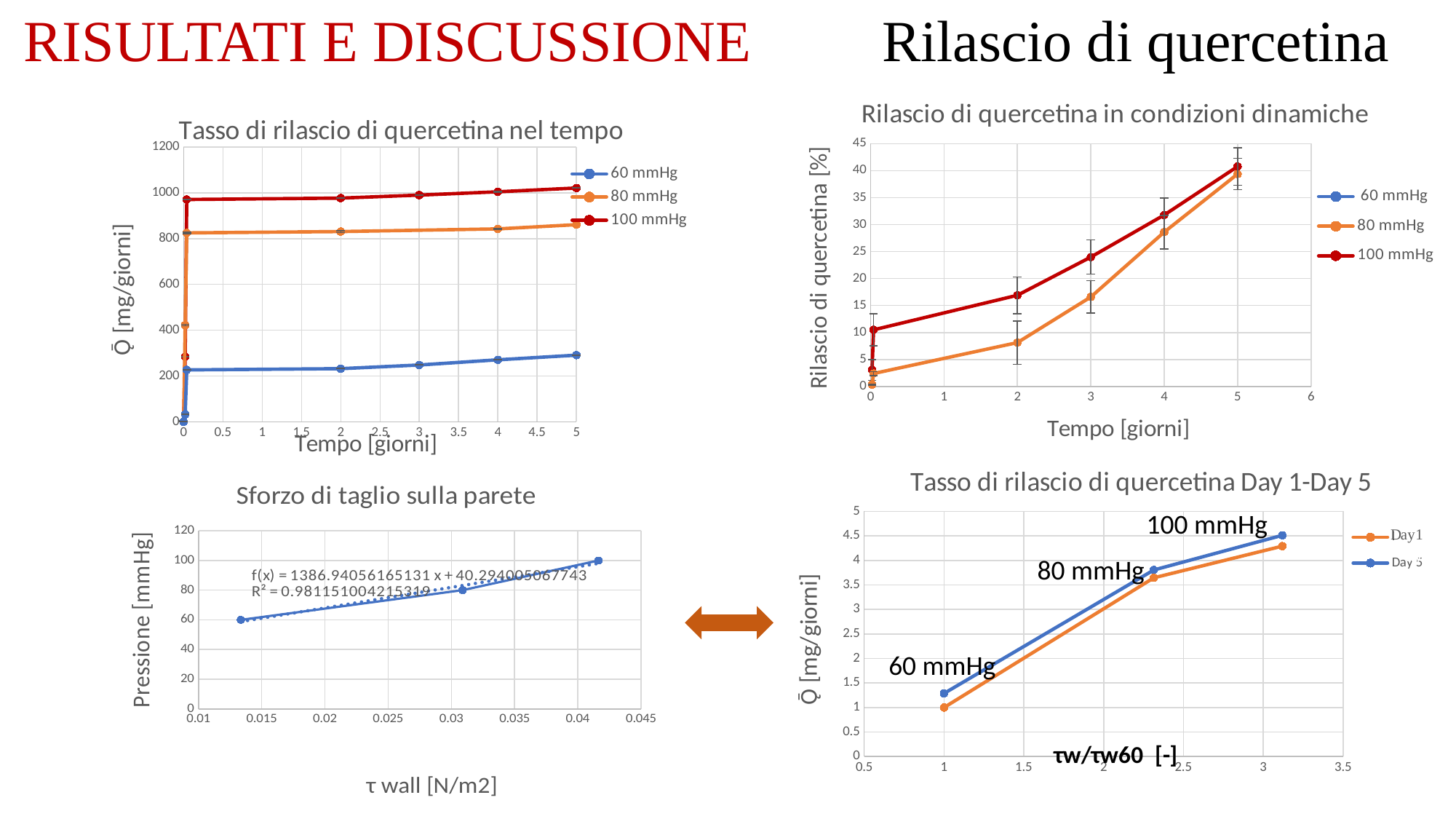
In the top-left chart 'Tasso di rilascio di quercetina nel tempo', is the value for 100 mmHg at day 5 greater or less than 800? greater In the top-left chart 'Tasso di rilascio di quercetina nel tempo', which series has the higher value at day 3: 100 mmHg or 60 mmHg? 100 mmHg In the top-right chart 'Rilascio di quercetina in condizioni dinamiche', do the values for 100 mmHg rise or fall as time increases? rise In the bottom-right chart 'Tasso di rilascio di quercetina Day 1-Day 5', how many series does the legend list? 2 In the top-left chart 'Tasso di rilascio di quercetina nel tempo', how many series does the legend list? 3 In the bottom-left chart 'Sforzo di taglio sulla parete', how many data points are plotted? 3 In the top-right chart 'Rilascio di quercetina in condizioni dinamiche', is the value for 100 mmHg at day 5 greater or less than 35? greater In the bottom-left chart 'Sforzo di taglio sulla parete', what is the highest Pressione value plotted? 100 In the top-left chart 'Tasso di rilascio di quercetina nel tempo', is the value for 60 mmHg at day 5 greater or less than 400? less In the top-right chart 'Rilascio di quercetina in condizioni dinamiche', what is the label of the y axis? Rilascio di quercetina [%] What kind of chart is the top-left chart titled 'Tasso di rilascio di quercetina nel tempo'? line chart In the bottom-right chart 'Tasso di rilascio di quercetina Day 1-Day 5', which series has the higher value at the 60 mmHg point: Day1 or Day 5? Day 5